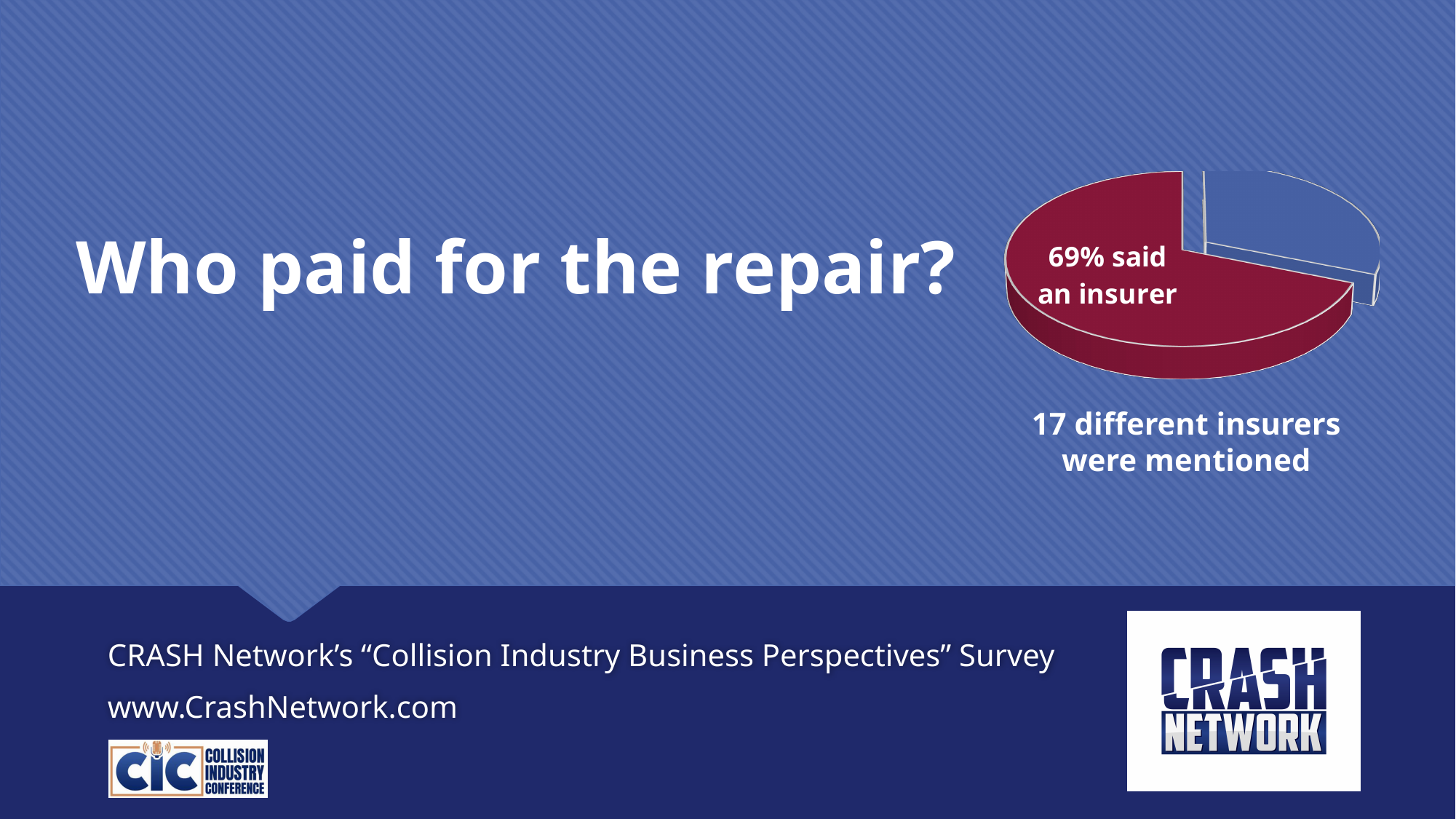
What percentage is printed on the red slice of the pie chart? 69% What share of respondents said an insurer paid for the repair? 69% What question does the slide title ask? Who paid for the repair? According to the text below the pie chart, how many different insurers were mentioned? 17 Which slice of the pie chart is larger, the red slice or the blue slice? the red slice Which slice of the pie chart is the smallest? the blue slice How many slices does the pie chart have? 2 What kind of chart is shown on the slide? pie chart What colour is the slice labelled '69% said an insurer'? red Which slice of the pie chart is the largest? the red slice (69% said an insurer)